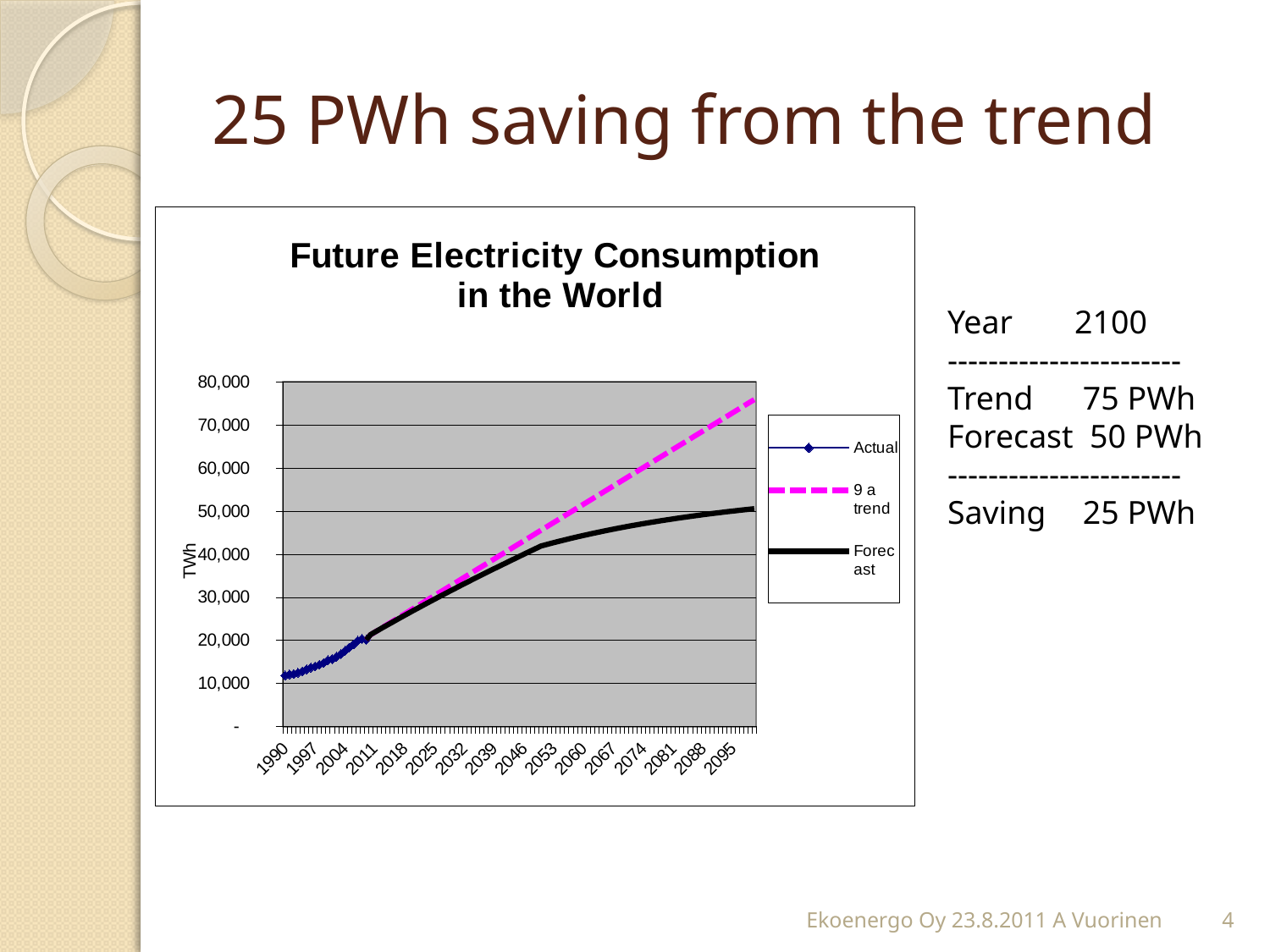
What kind of chart is shown on the slide? line chart Is the value of the 9 a trend series at 2095 greater or less than 70,000? greater Does the Forecast series rise or fall from 2011 to 2095? rise Is the value of the Forecast series at 2053 greater or less than 50,000? less What is the title of the chart? Future Electricity Consumption in the World Is the value of the Forecast series at 2095 greater or less than 60,000? less Does the 9 a trend series rise or fall along the x axis? rise At 2095, which series has the larger value, 9 a trend or Forecast? 9 a trend How many series does the chart legend list? 3 What unit is shown on the y axis of the chart? TWh